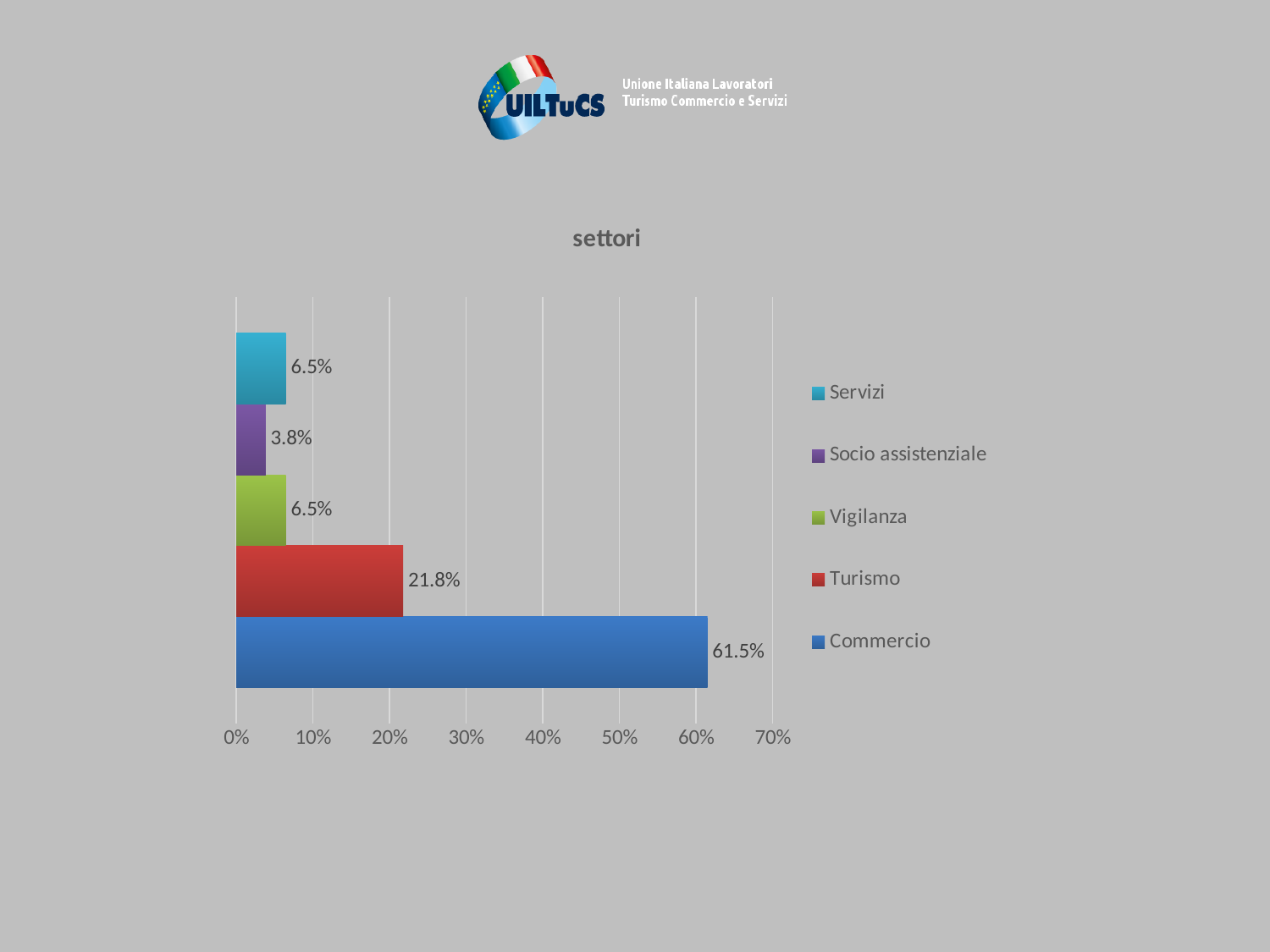
What is the value for Vigilanza? 6.5% Which is larger, the value for Turismo or the value for Servizi? Turismo Which sector has the highest value? Commercio What is the title of the chart? settori How many series does the legend list? 5 What is the value for Turismo? 21.8% What is the difference between the values for Commercio and Turismo? 39.7% What is the value for Socio assistenziale? 3.8% What is the value for Commercio? 61.5% What kind of chart is shown on the slide? bar chart Which sector has the lowest value? Socio assistenziale Is the value for Commercio greater or less than 60%? greater